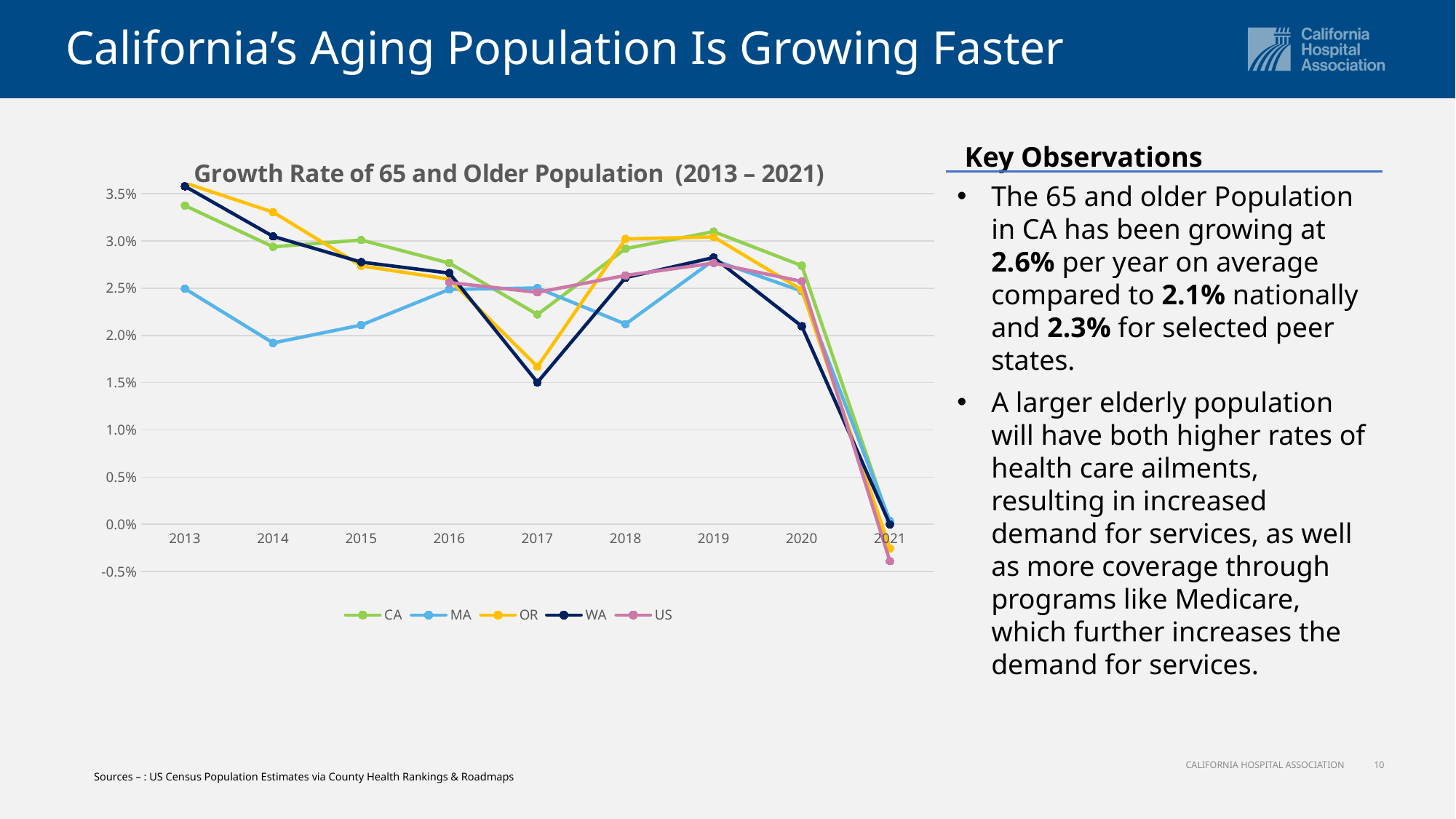
Which series has the highest value in 2014? OR Is the value for OR in 2017 greater or less than 2.0%? less Which series has the lowest value in 2017? WA Is the value for CA in 2013 greater or less than 3.0%? greater How many series does the chart legend list? 5 How many years are plotted along the x axis of the chart? 9 What kind of chart is shown on the slide? line chart Is the value for US in 2021 greater or less than 0.0%? less In 2017, which is larger, the value for CA or the value for WA? CA Which series in the chart is drawn in green? CA What is the title of the chart? Growth Rate of 65 and Older Population (2013 – 2021)